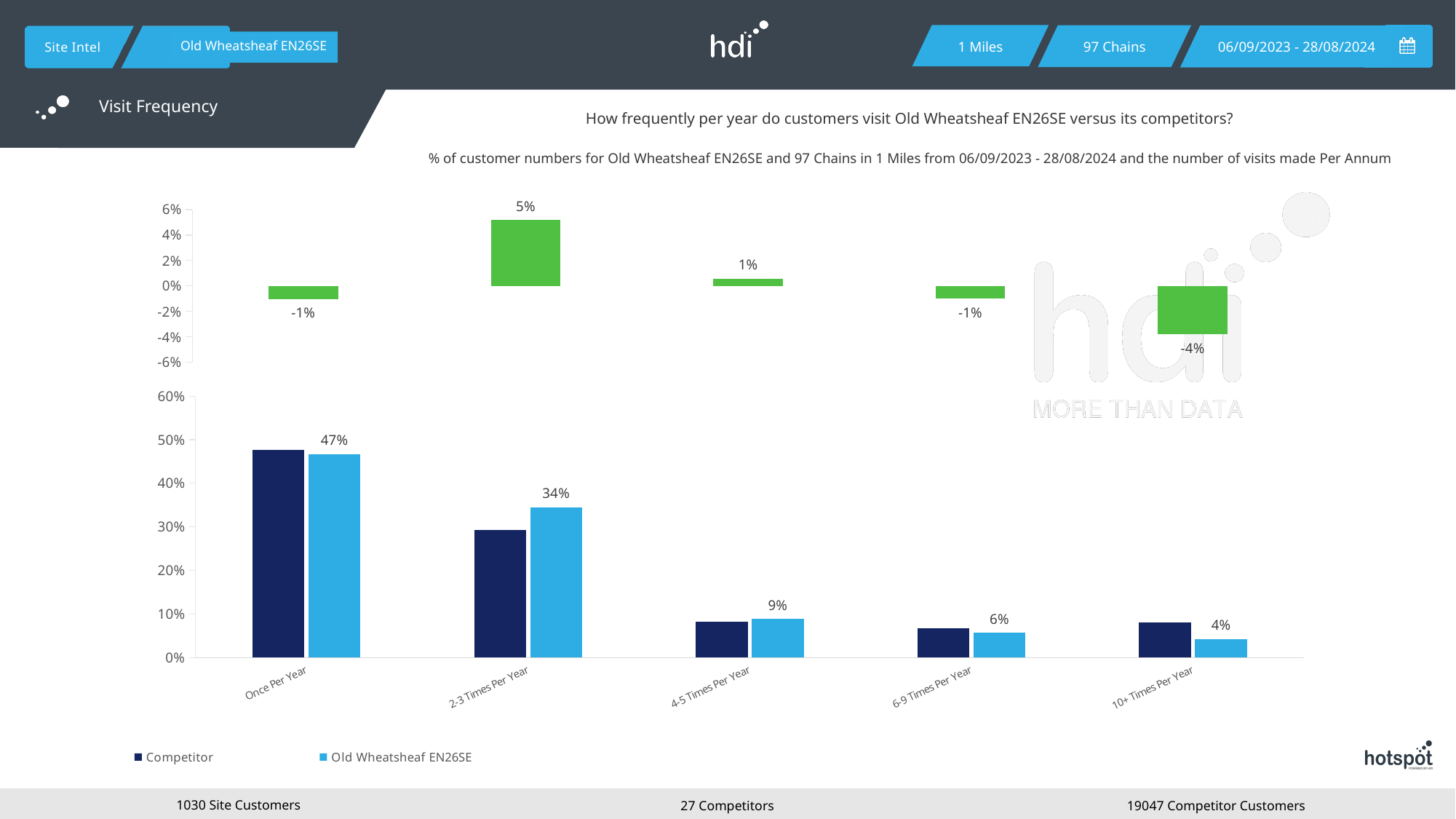
In the bottom bar chart, which category has the highest value for Old Wheatsheaf EN26SE? Once Per Year In the bottom bar chart, what is the value for Old Wheatsheaf EN26SE for 2-3 Times Per Year? 34% In the bottom bar chart, what is the difference between the Old Wheatsheaf EN26SE values for Once Per Year and 2-3 Times Per Year? 13% In the bottom bar chart, which is larger for 10+ Times Per Year, Competitor or Old Wheatsheaf EN26SE? Competitor In the bottom bar chart, what is the value for Old Wheatsheaf EN26SE for Once Per Year? 47% How many categories are shown on the x axis of the bottom bar chart? 5 In the bottom bar chart, what is the value for Old Wheatsheaf EN26SE for 10+ Times Per Year? 4% In the bottom bar chart, which category has the lowest value for Old Wheatsheaf EN26SE? 10+ Times Per Year How many series does the legend of the bottom bar chart list? 2 In the top chart, what is the value shown for 10+ Times Per Year? -4% In the top chart, what is the value shown for 2-3 Times Per Year? 5% In the bottom bar chart, is the Competitor value for 2-3 Times Per Year greater or less than 20%? greater